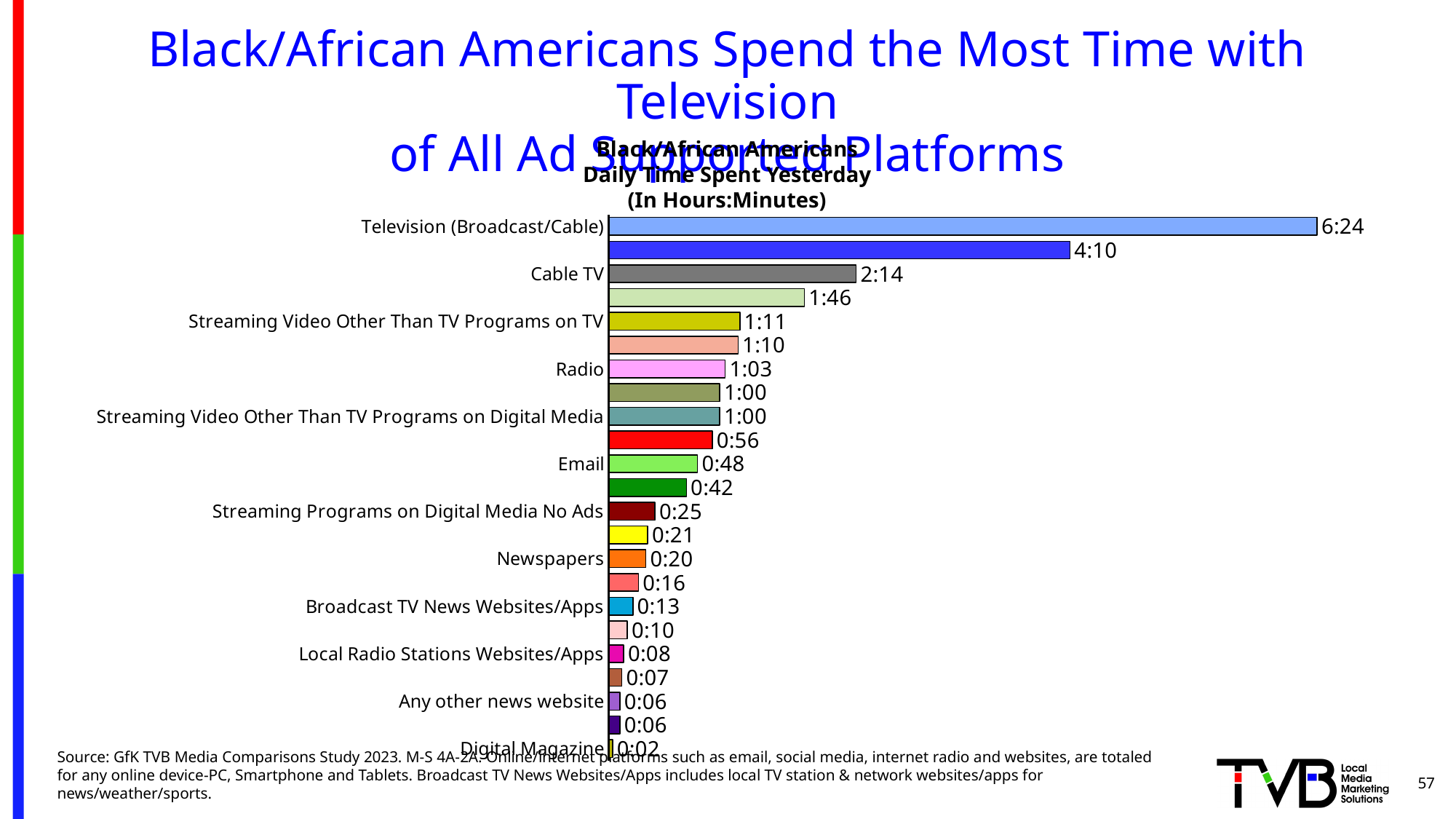
What is the daily time spent for Cable TV? 2:14 What is the daily time spent for Television (Broadcast/Cable)? 6:24 Which category has the highest daily time spent? Television (Broadcast/Cable) What kind of chart is shown on the slide? Bar chart What is the daily time spent for Email? 0:48 Which category has the lowest daily time spent? Digital Magazine What is the daily time spent for Radio? 1:03 What is the daily time spent for Digital Magazine? 0:02 What is the daily time spent for Newspapers? 0:20 How much more daily time is spent with Television (Broadcast/Cable) than with Cable TV? 4:10 How many bars are plotted in the chart? 23 Which has a higher daily time spent, Radio or Email? Radio